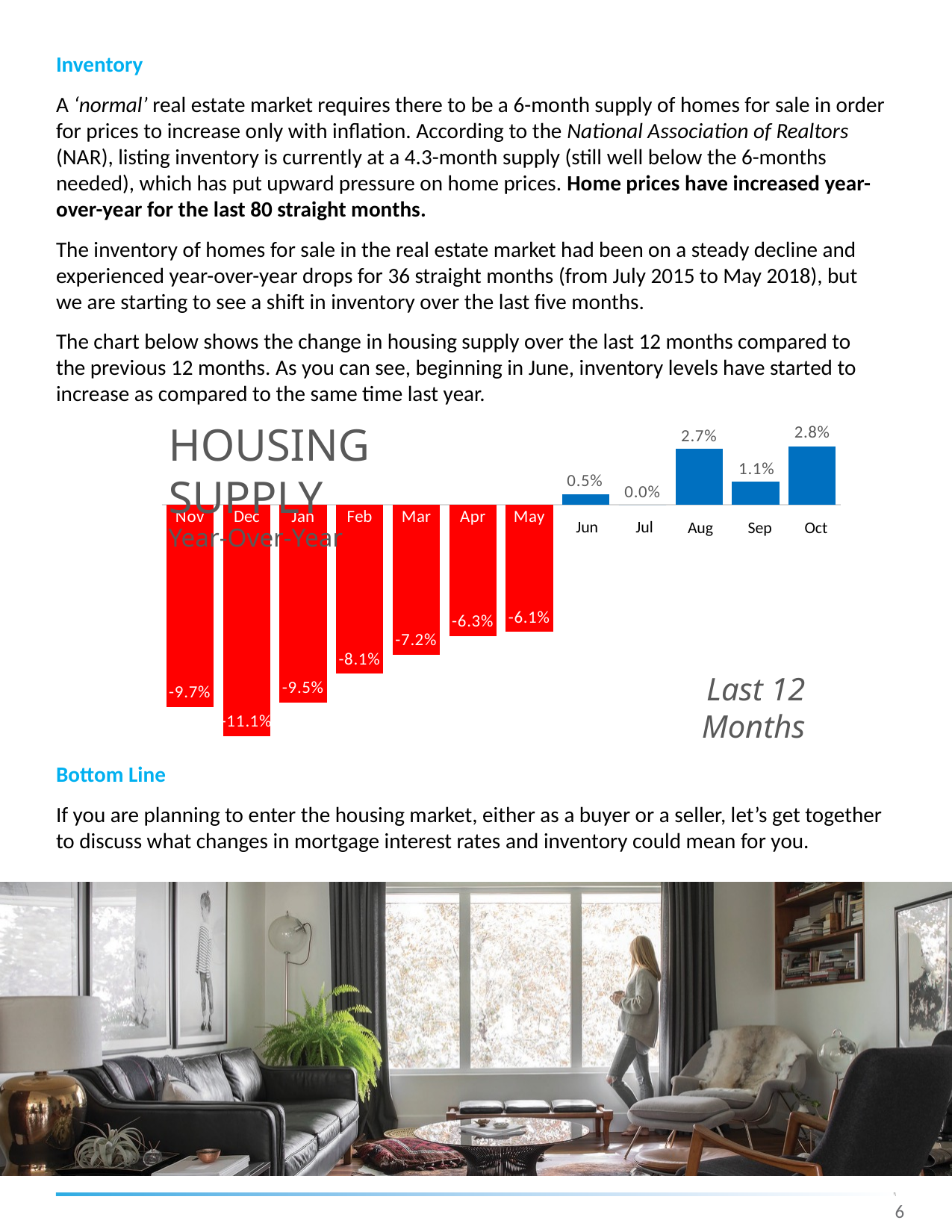
What is the value shown for Aug? 2.7% Which month has the lowest value in the chart? Dec What is the difference between the values for Aug and Sep? 1.6 percentage points What is the difference between the values for Oct and Dec? 13.9 percentage points What kind of chart is shown? Bar chart Which month has the highest value in the chart? Oct What is the value shown for Jul? 0.0% Which is larger, the value for Apr or the value for Mar? Apr How many months are plotted in the chart? 12 What is the value shown for Mar? -7.2% Do the values generally rise or fall from Nov to Oct? Rise What is the year-over-year housing supply change for Dec? -11.1%